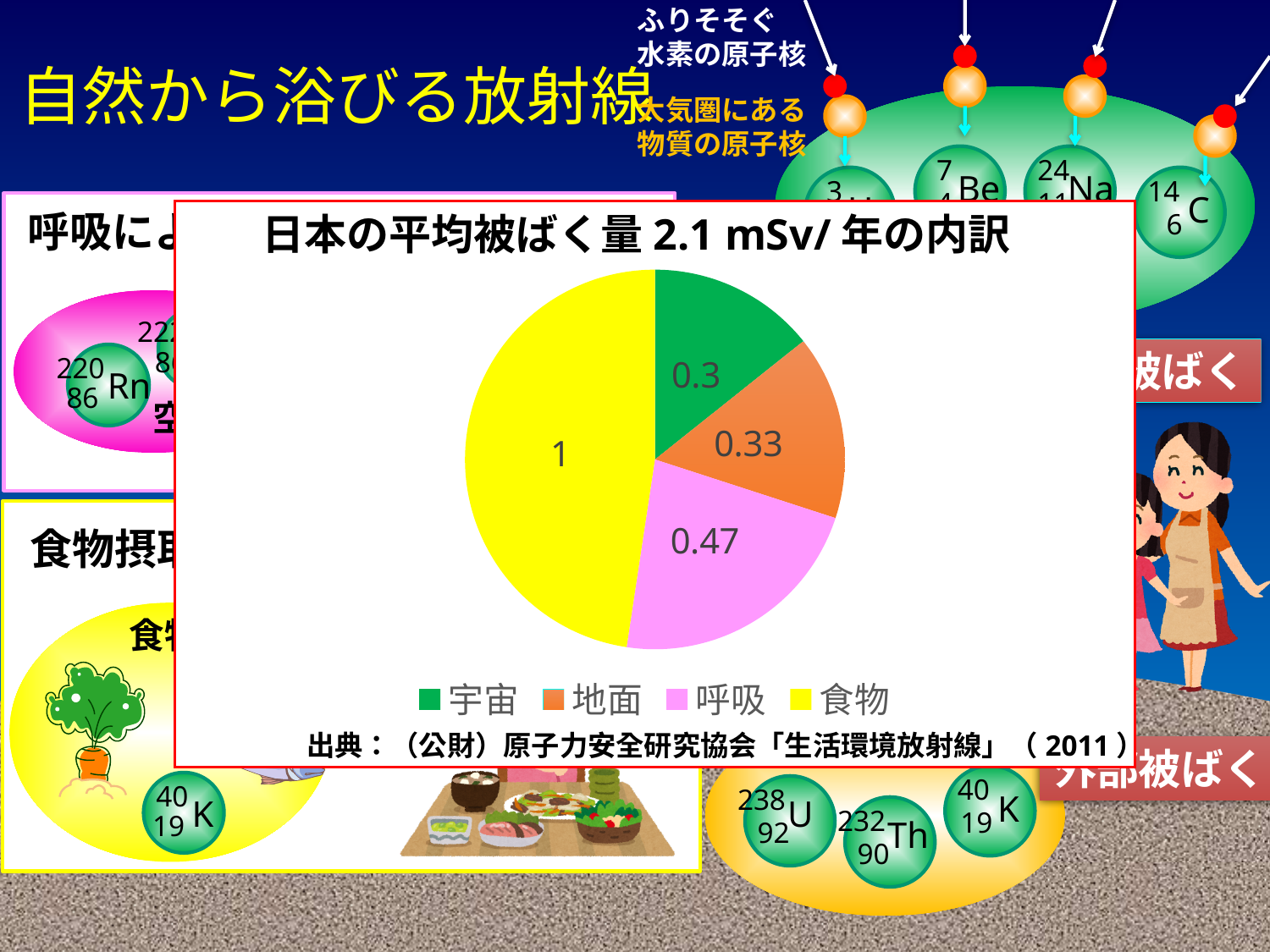
What is the difference between the values for 食物 and 呼吸? 0.53 What is the value for 地面 in the pie chart? 0.33 What kind of chart is shown on the slide? pie chart How many categories does the pie chart have? 4 What is the value for 呼吸 in the pie chart? 0.47 Which category has the largest slice in the pie chart? 食物 Which is larger, the value for 地面 or the value for 宇宙? 地面 What is the title of the pie chart? 日本の平均被ばく量 2.1 mSv/年の内訳 Which category has the smallest slice in the pie chart? 宇宙 What colour is the 呼吸 slice in the pie chart? pink What is the value for 宇宙 in the pie chart? 0.3 What is the value for 食物 in the pie chart? 1